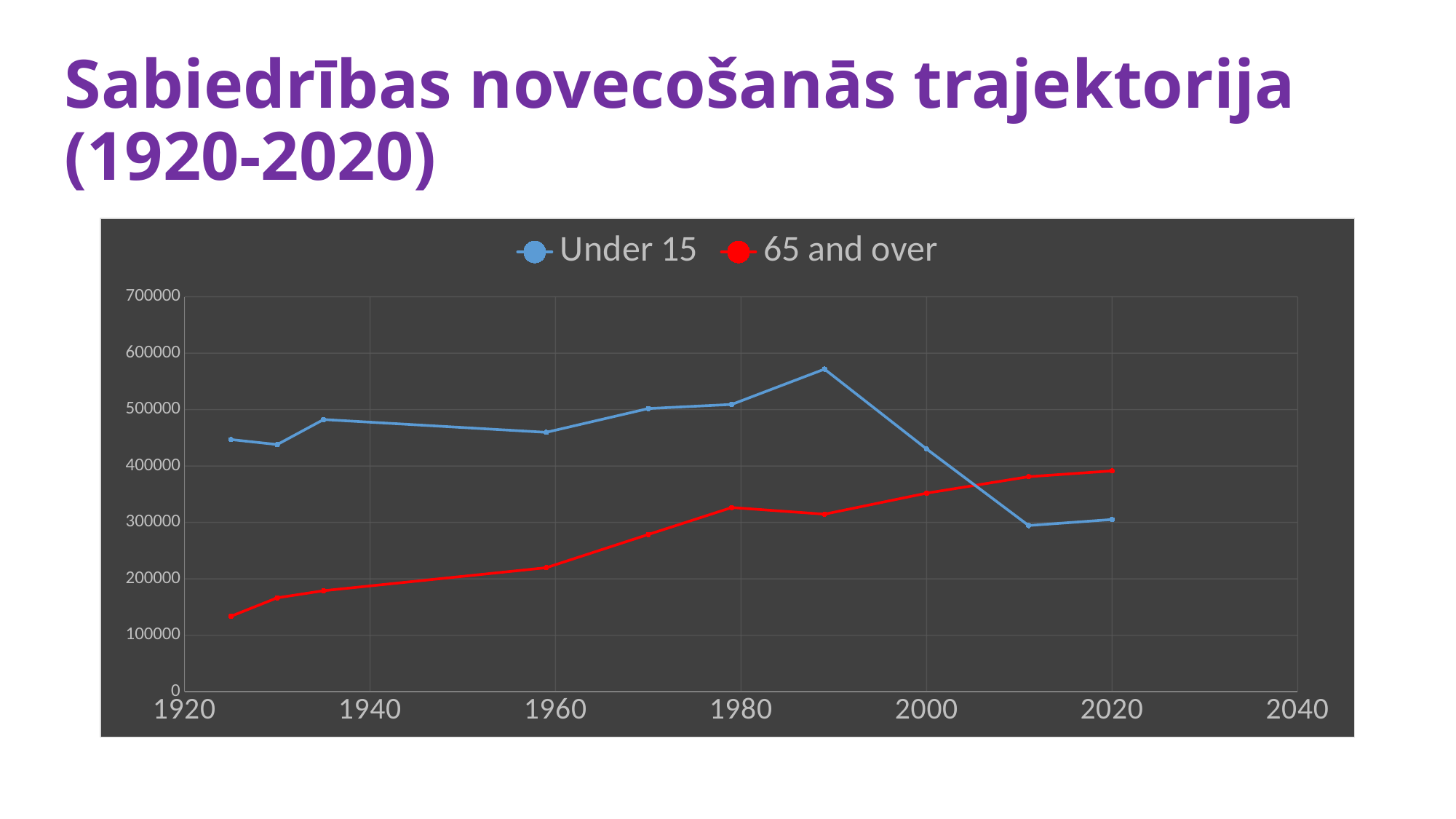
What kind of chart is shown on the slide? line chart Around 1980, which series has the higher value, Under 15 or 65 and over? Under 15 Is the 65 and over value around 1980 greater or less than 300000? greater Is the first (1920s) value of the Under 15 series greater or less than 500000? less What are the two series named in the legend? Under 15 and 65 and over Does the 65 and over series generally rise or fall from 1920 to 2020? rise Is the first (1920s) value of the 65 and over series greater or less than 100000? greater How many series does the legend list? 2 At 2020, which series has the higher value, Under 15 or 65 and over? 65 and over Which colour is used for the 65 and over series? red How many data points are plotted for the Under 15 series? 10